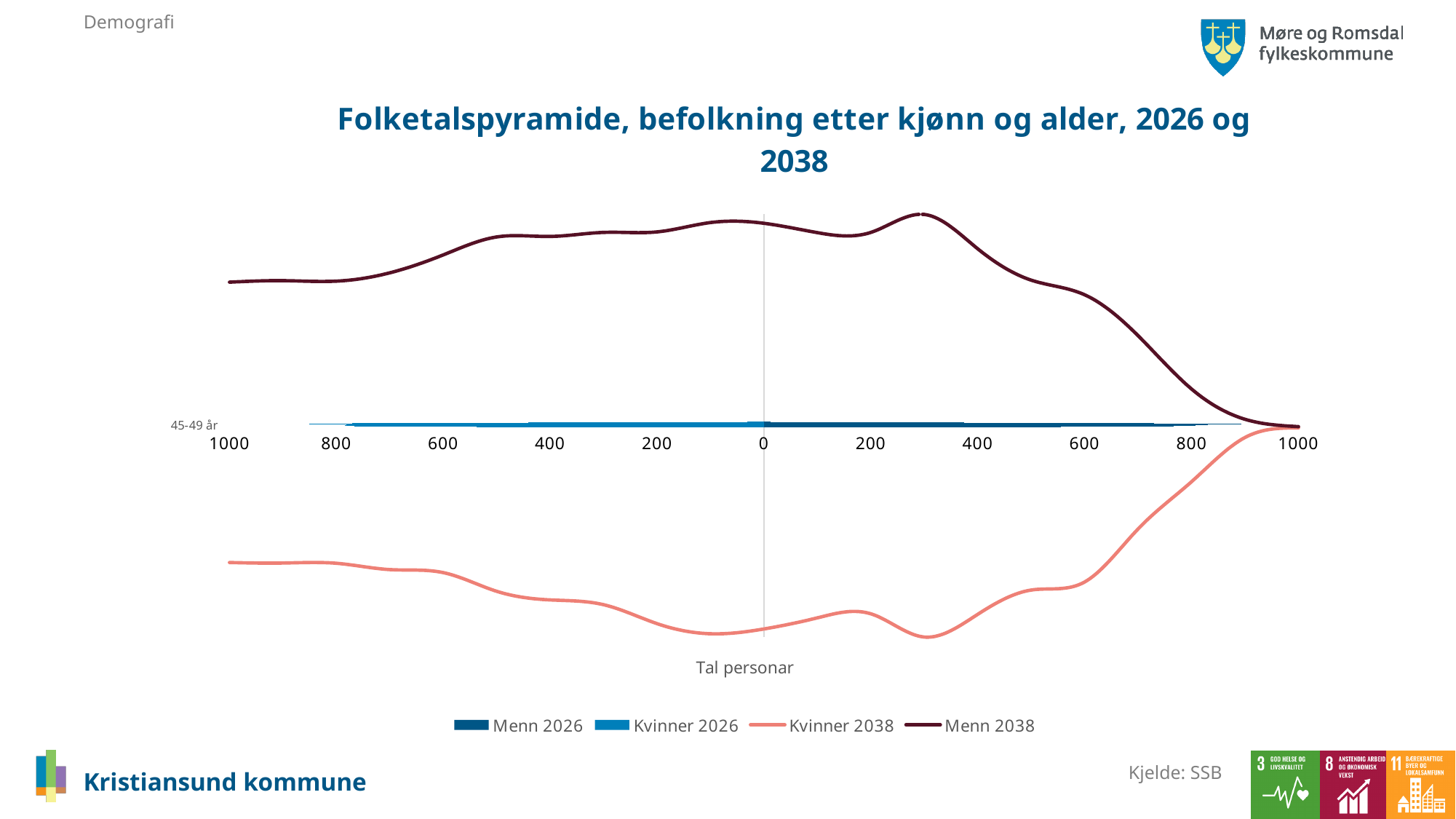
How many series does the chart legend list? 4 What is the label on the horizontal axis of the chart? Tal personar What is the highest value shown on the horizontal axis of the chart? 1000 Which age group label is shown on the vertical axis of the chart? 45-49 år What is the title of the chart? Folketalspyramide, befolkning etter kjønn og alder, 2026 og 2038